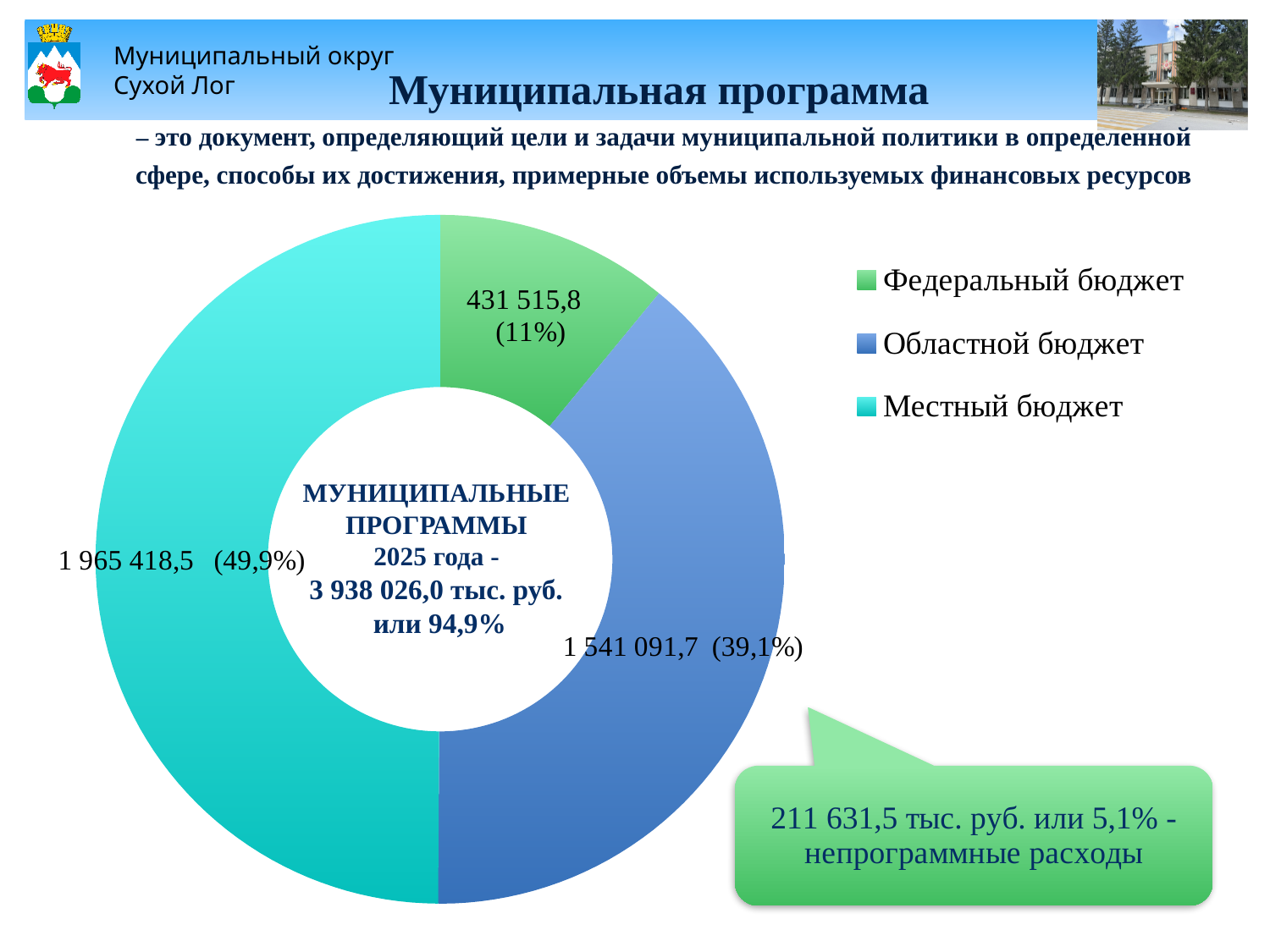
Which budget source has the largest value in the chart? Местный бюджет What is the value shown for Местный бюджет? 1 965 418,5 What kind of chart is shown on the slide? Doughnut (pie) chart What share of the chart does Местный бюджет represent? 49,9% Which is larger, the value for Областной бюджет or the value for Федеральный бюджет? Областной бюджет How many categories does the legend of the chart list? 3 What is the value shown for Областной бюджет? 1 541 091,7 What share of the chart does Областной бюджет represent? 39,1% What is the value shown for Федеральный бюджет? 431 515,8 What total amount for municipal programmes in 2025 is printed in the centre of the chart? 3 938 026,0 тыс. руб. What share of the chart does Федеральный бюджет represent? 11% Which budget source has the smallest value in the chart? Федеральный бюджет